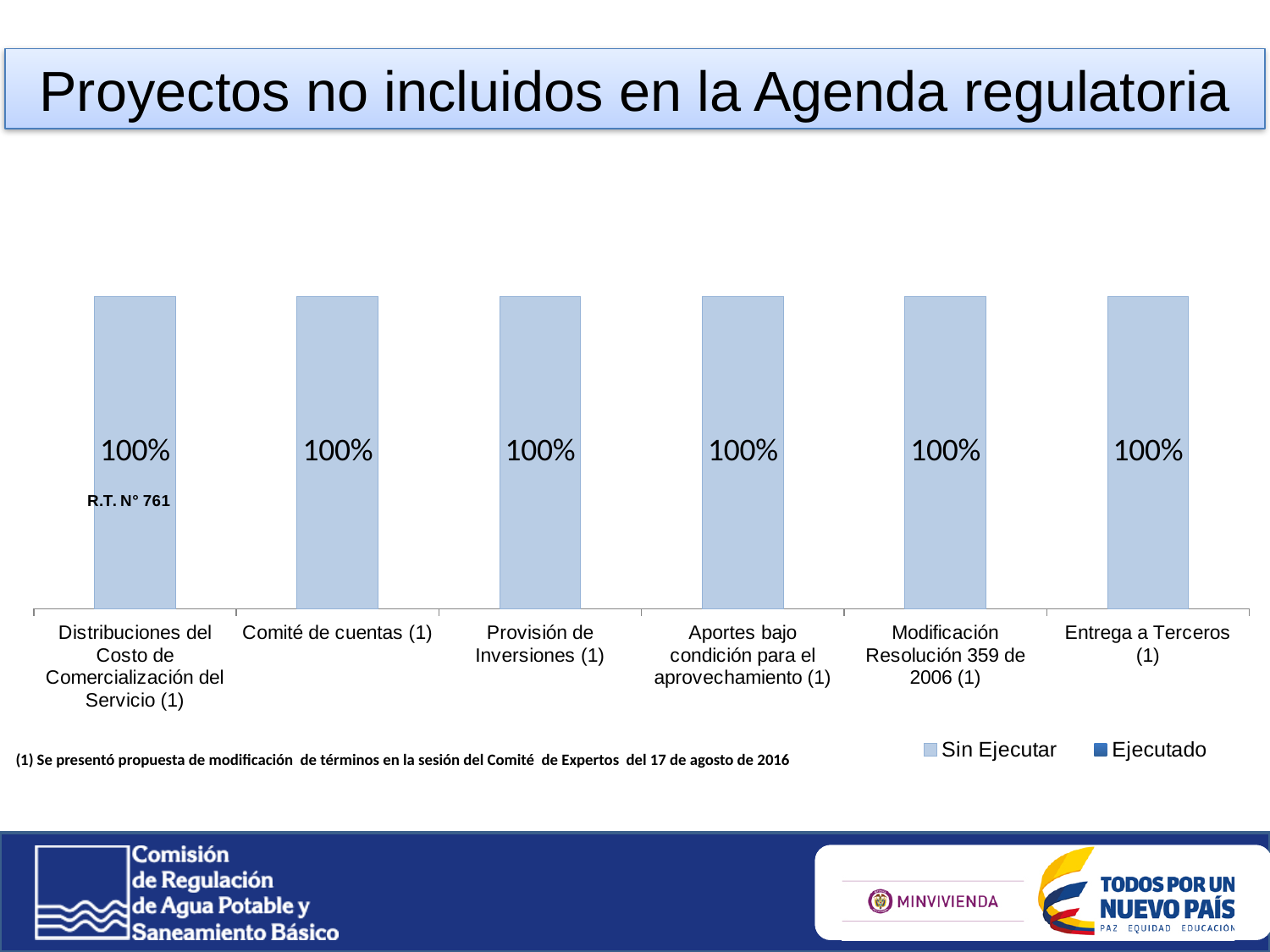
What is the value for Entrega a Terceros (1)? 100% What is the value for Provisión de Inversiones (1)? 100% What is the difference between the values for Aportes bajo condición para el aprovechamiento (1) and Distribuciones del Costo de Comercialización del Servicio (1)? 0% What is the total of the stacked bar for Comité de cuentas (1)? 100% How many series does the chart legend list? 2 What kind of chart is shown on the slide? bar chart What is the value for Modificación Resolución 359 de 2006 (1)? 100% Which series does the legend list first? Sin Ejecutar What is the value for Comité de cuentas (1)? 100% How many categories are shown on the x axis of the chart? 6 Do the values rise, fall, or stay the same across the categories from left to right? stay the same Which series does the legend list second? Ejecutado